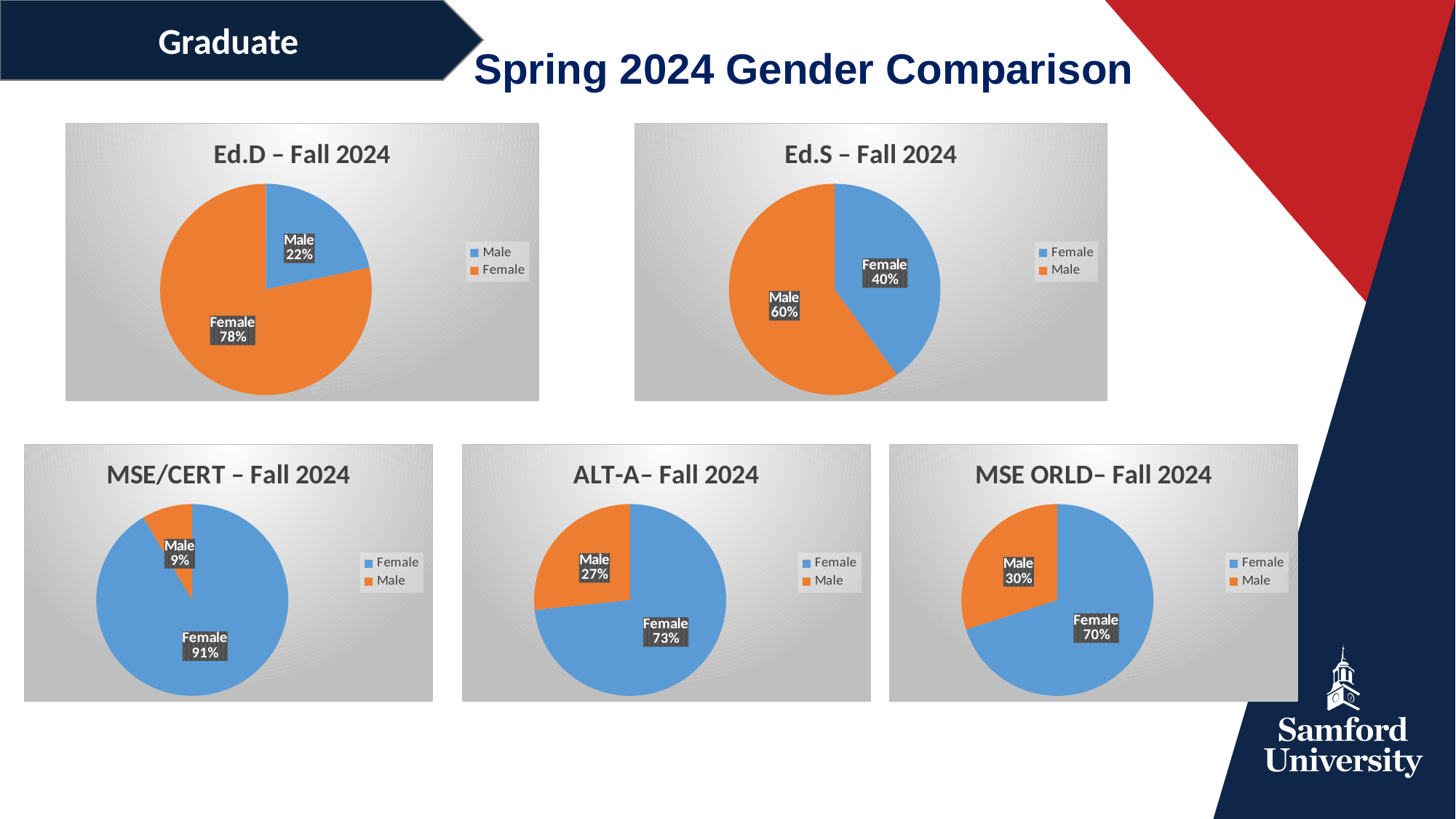
In the Ed.D – Fall 2024 chart, what is the value for Male? 22% In the Ed.S – Fall 2024 chart, which is larger, Female or Male? Male In the Ed.D – Fall 2024 chart, what share of the pie is Female? 78% In the MSE/CERT – Fall 2024 chart, what is the value for Male? 9% In the MSE ORLD– Fall 2024 chart, what is the value for Male? 30% How many slices does the ALT-A– Fall 2024 pie chart have? 2 What kind of chart is the Ed.D – Fall 2024 chart? Pie chart In the ALT-A– Fall 2024 chart, what share of the pie is Female? 73% In the Ed.S – Fall 2024 chart, what share of the pie is Male? 60% In the MSE ORLD– Fall 2024 chart, which slice is the largest? Female In the MSE/CERT – Fall 2024 chart, what is the difference between the Female and Male shares? 82% How many pie charts are shown on the slide? 5